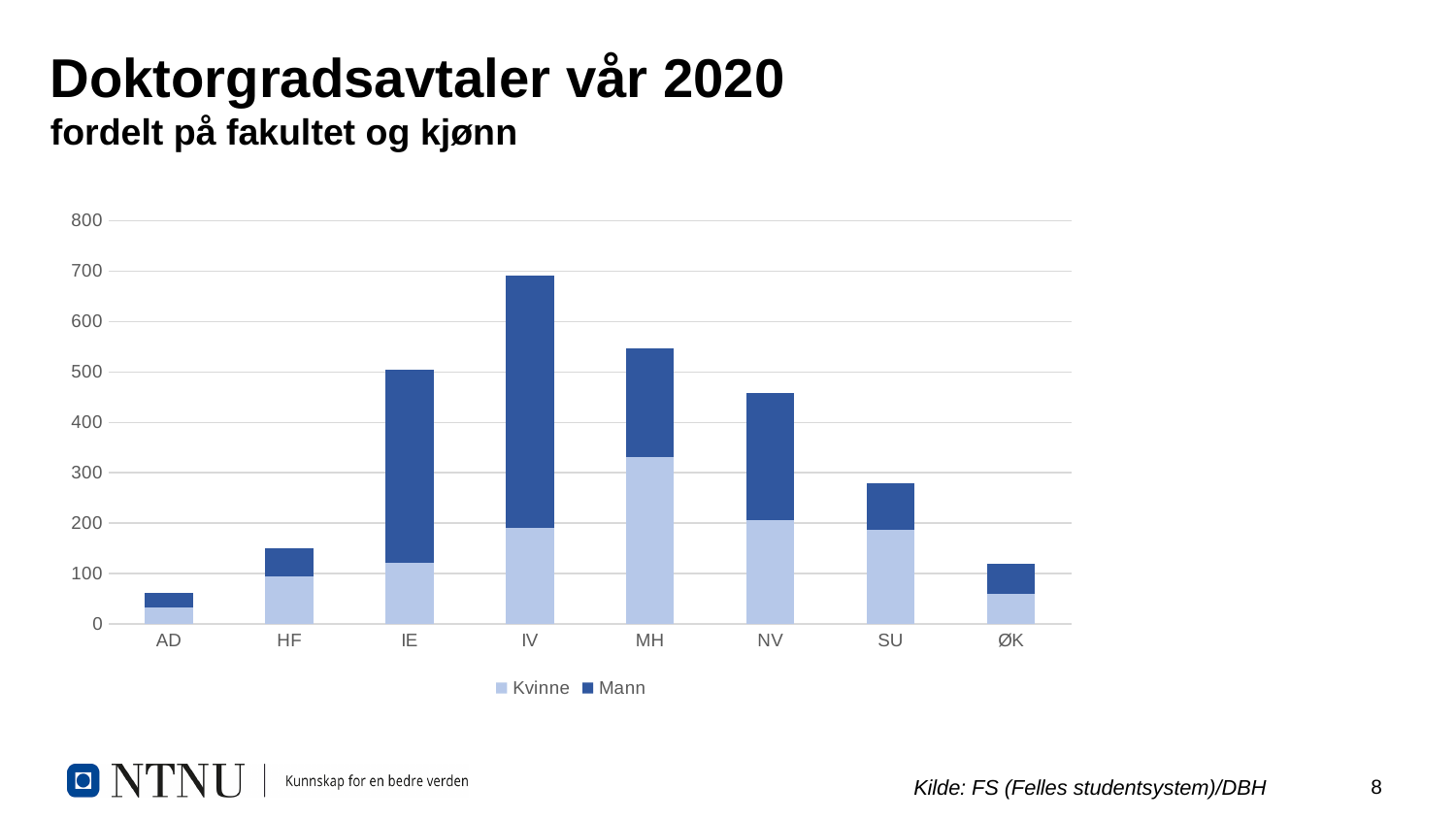
Is the total value for AD greater or less than 100? less Is the Kvinne value for MH greater or less than 300? greater Which has the larger total, IE or NV? IE Which faculty has the highest total number of doctoral agreements? IV Is the Kvinne value for IE greater or less than 200? less Which faculty has the highest Kvinne value? MH What are the two series named in the legend? Kvinne and Mann How many faculties are shown on the x axis of the chart? 8 What kind of chart is shown on the slide? Stacked bar chart Which faculty has the lowest total number of doctoral agreements? AD How many series does the legend list? 2